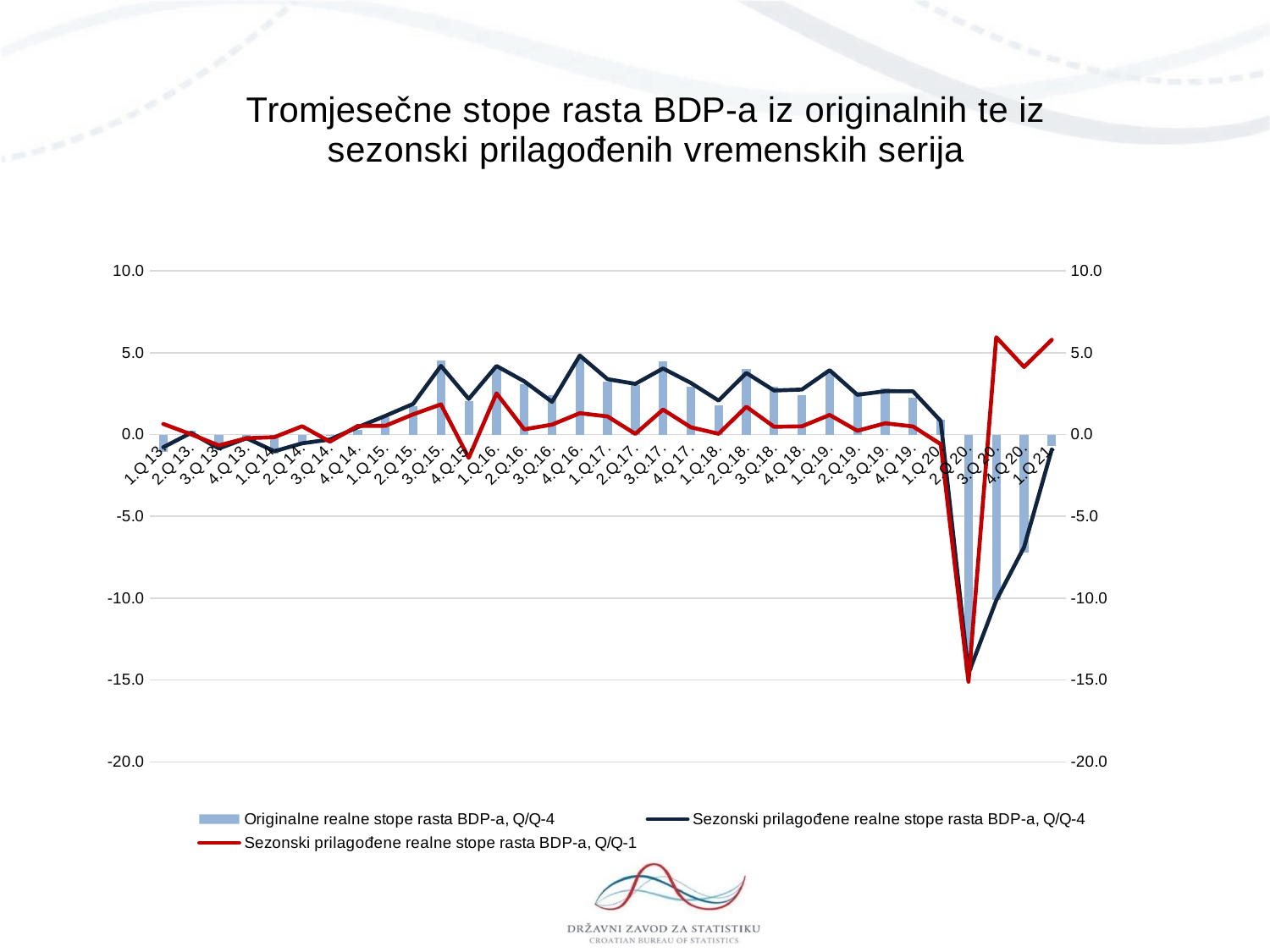
How many quarters are shown on the x axis? 33 What is the title of the chart? Tromjesečne stope rasta BDP-a iz originalnih te iz sezonski prilagođenih vremenskih serija In which quarter is the bar for Originalne realne stope rasta BDP-a, Q/Q-4 lowest? 2.Q 20. Is the bar value for 2.Q.20. greater or less than -10.0? less Do the bar values rise or fall from 1.Q.20. to 2.Q.20.? fall Which bar is larger, 2.Q.20. or 3.Q.20.? 3.Q.20. What kind of chart is this? Combined bar and line chart How many series does the legend list? 3 Is the bar value for 4.Q.20. greater or less than -5.0? less Which series is drawn as bars? Originalne realne stope rasta BDP-a, Q/Q-4 Is the bar value for 3.Q.15. greater or less than 0.0? greater